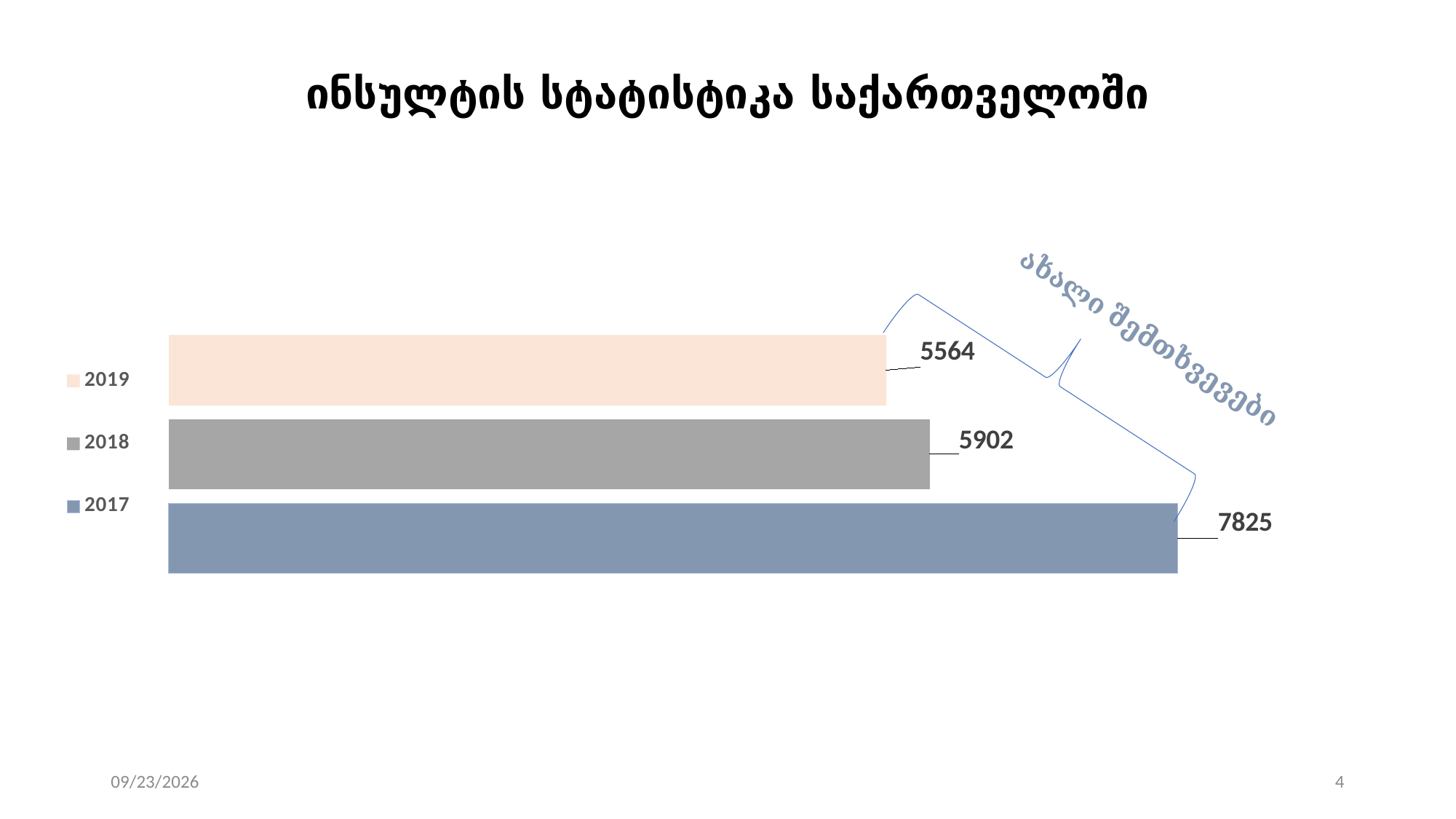
What kind of chart is shown on the slide? Bar chart Which year has the lowest value? 2019 What is the value for 2017? 7825 How many entries does the legend list? 3 What is the value for 2018? 5902 How many bars are shown in the chart? 3 What is the title of the slide? ინსულტის სტატისტიკა საქართველოში Which is larger, the value for 2018 or the value for 2019? 2018 What is the value for 2019? 5564 Which year has the highest value? 2017 What is the difference between the values for 2018 and 2019? 338 What is the difference between the values for 2017 and 2019? 2261